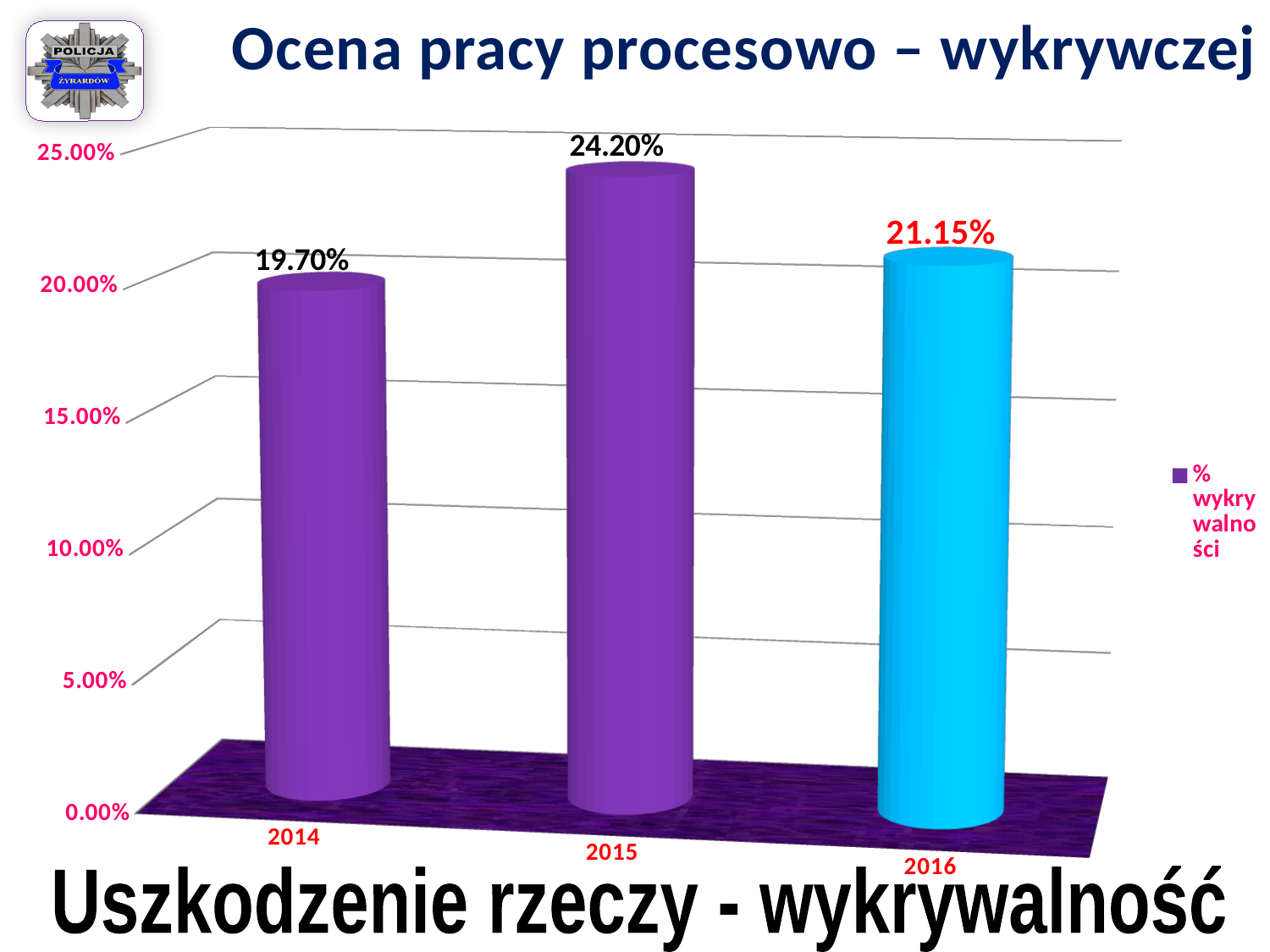
What kind of chart is shown on the slide? bar chart What is the value for 2015? 24.20% What is the difference between the values for 2015 and 2016? 3.05% What is the value for 2016? 21.15% Which year has the lowest value? 2014 Which year has the highest value? 2015 What is the value for 2014? 19.70% Is the value for 2015 greater or less than 20.00%? greater What is the text below the chart? Uszkodzenie rzeczy - wykrywalność What is the difference between the values for 2015 and 2014? 4.50% How many years are shown on the chart? 3 Which is larger, the value for 2016 or the value for 2014? 2016